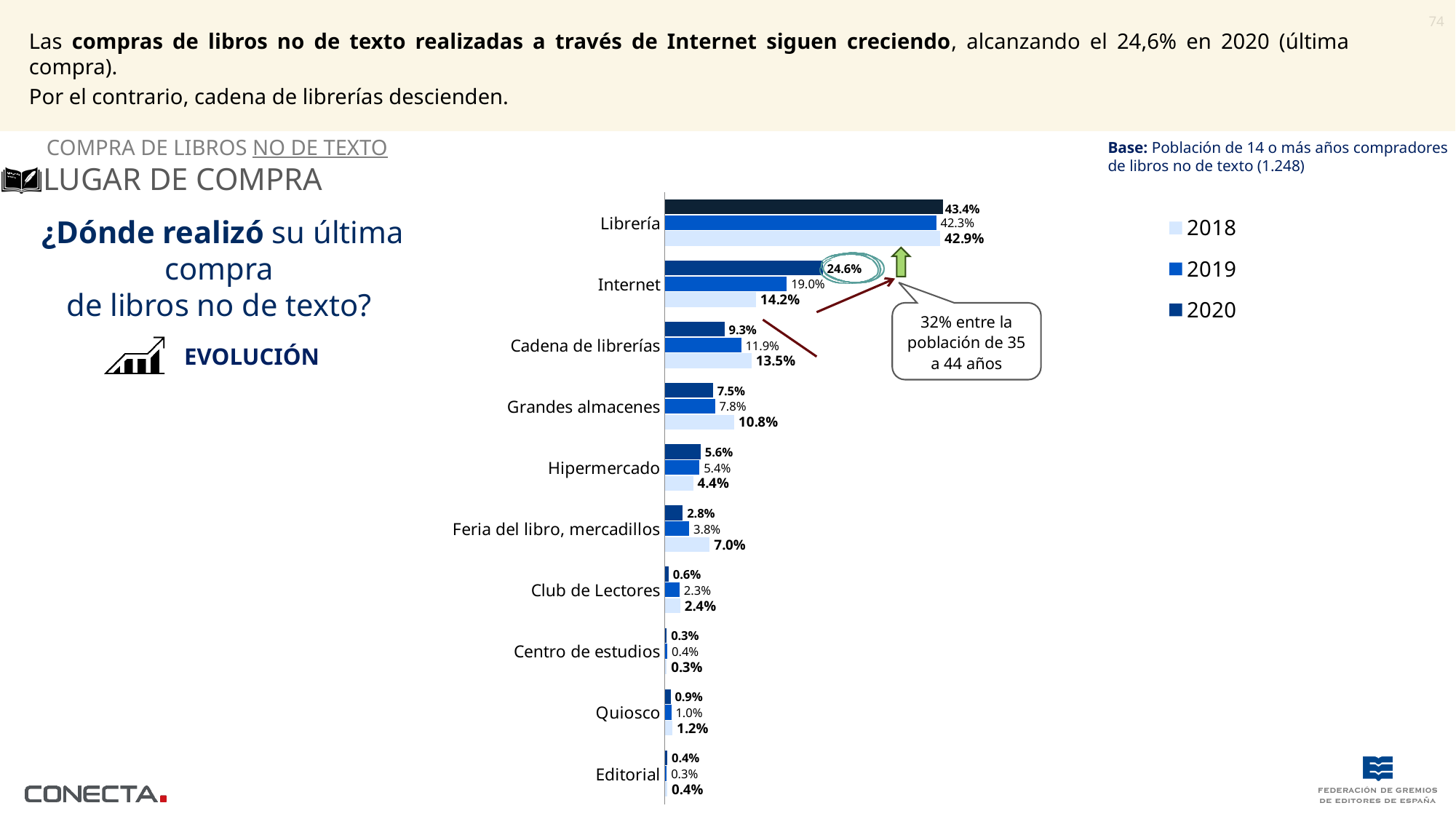
Which legend entry is shown in the darkest colour? 2020 Which category has the highest 2020 value? Librería How many purchase-place categories are shown in the chart? 10 What kind of chart is shown on the slide? bar chart What is the 2020 value for Internet? 24.6% Which category has the lowest 2019 value? Editorial Do the values for Cadena de librerías rise or fall from 2018 to 2020? fall What is the 2019 value for Grandes almacenes? 7.8% How many series does the legend list? 3 Which is larger for Hipermercado, the 2020 value or the 2018 value? 2020 What is the difference between the 2020 and 2018 values for Internet? 10.4% What is the 2018 value for Cadena de librerías? 13.5%